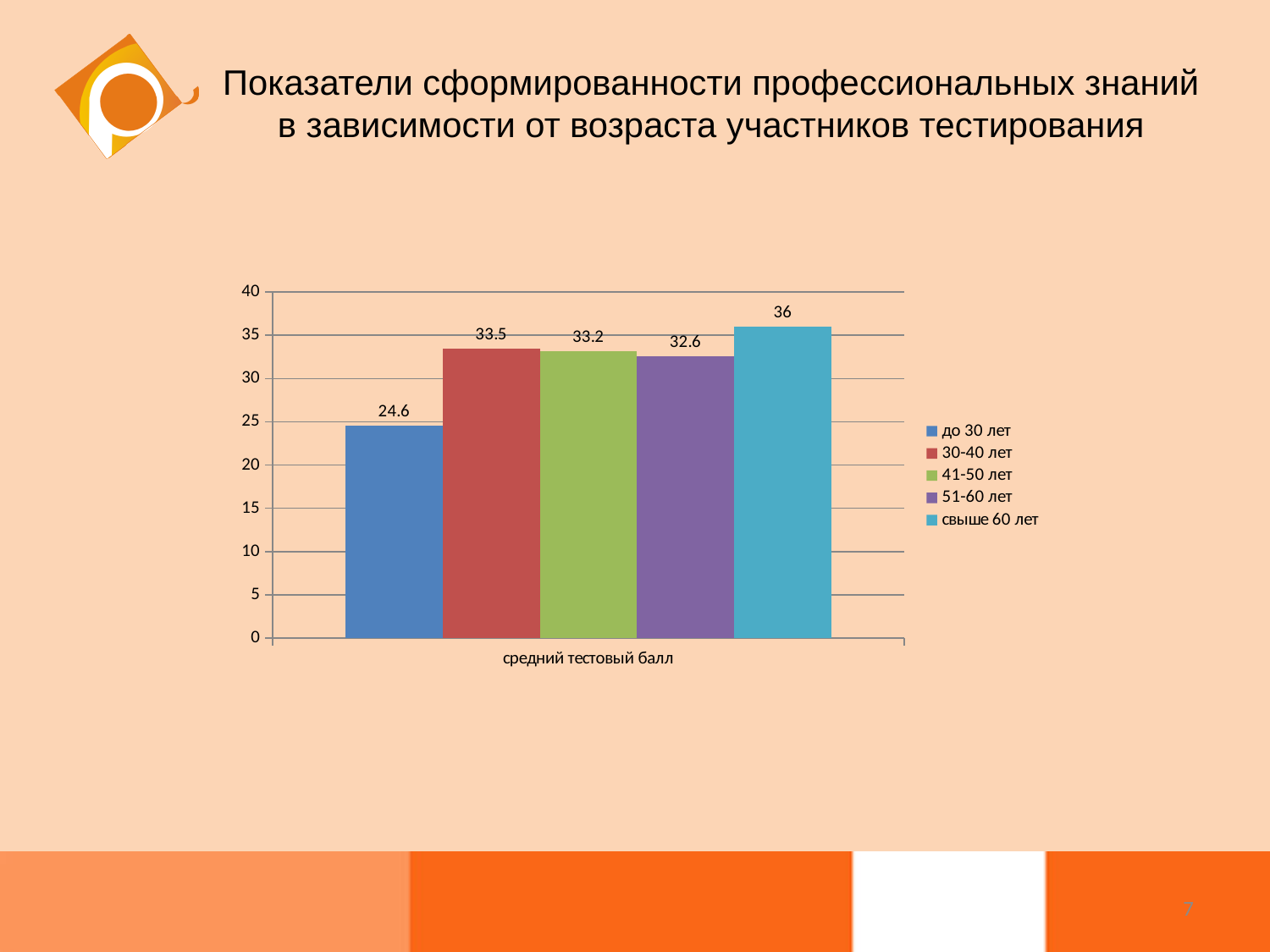
Which group has a higher average test score: '30-40 лет' or '51-60 лет'? 30-40 лет What is the difference between the average test scores of the 'свыше 60 лет' and 'до 30 лет' groups? 11.4 What is the average test score for the 'до 30 лет' group? 24.6 What is the average test score for the '51-60 лет' group? 32.6 What kind of chart is shown on the slide? bar chart Which age group has the highest average test score? свыше 60 лет What is the difference between the average test scores of the '30-40 лет' and '41-50 лет' groups? 0.3 Which age group has the lowest average test score? до 30 лет How many series does the legend list? 5 What is the average test score for the 'свыше 60 лет' group? 36 What is the label on the x axis of the chart? средний тестовый балл What is the average test score for the '30-40 лет' group? 33.5